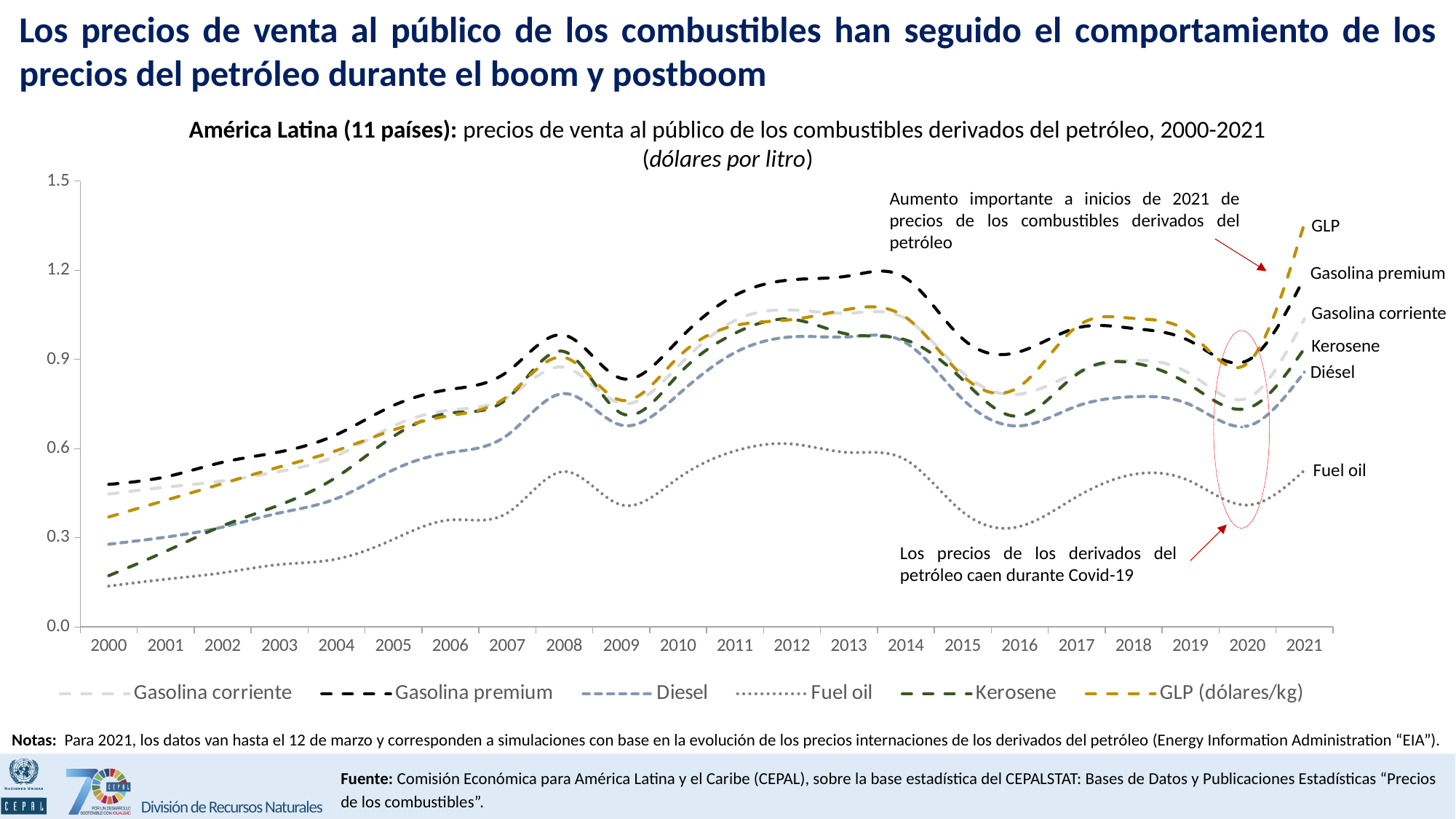
How many series does the legend list? 6 How many years are shown along the x axis? 22 Which series has the lowest value in 2000? Fuel oil Is the value for GLP in 2021 greater or less than 1.2? greater What kind of chart is shown on the slide? Line chart Is the value for Gasolina premium in 2000 greater or less than 0.6? less Does the Fuel oil series rise or fall from 2000 to 2008? Rises Is the value for Fuel oil in 2000 greater or less than 0.3? less Which series has the highest value in 2021? GLP In 2000, which is larger: Gasolina premium or Kerosene? Gasolina premium According to the legend, what unit is used for the GLP series? dólares/kg Which series has the lowest value in 2021? Fuel oil